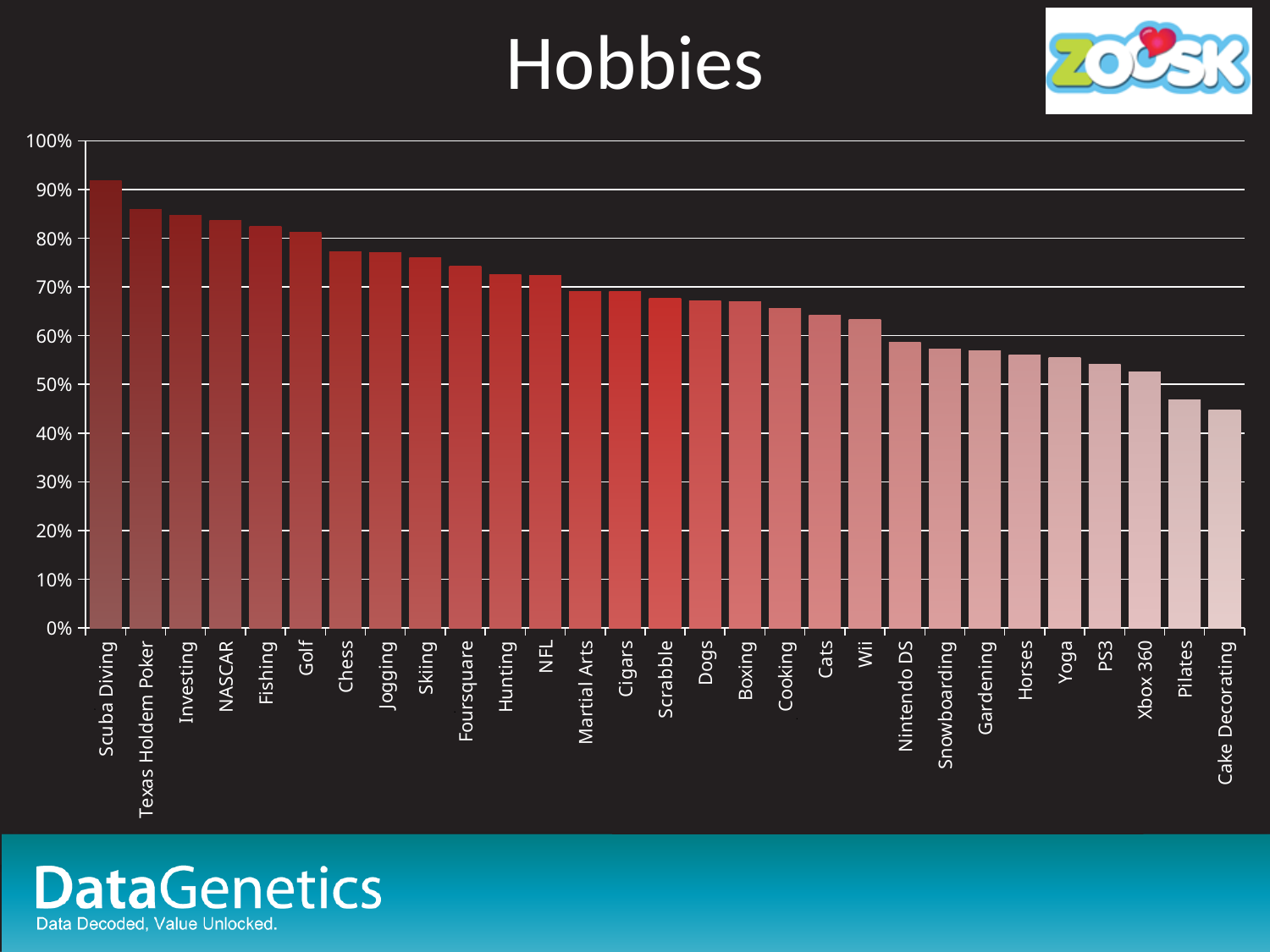
How many hobbies are plotted on the chart? 29 Is the value for Scuba Diving greater or less than 90%? greater Is the value for Chess greater or less than 80%? less What kind of chart is shown on the slide? bar chart Which is larger, the value for Fishing or the value for Yoga? Fishing Do the values rise or fall moving from left to right along the x axis? fall Is the value for Cooking greater or less than 60%? greater Which hobby has the highest value? Scuba Diving What is the title of the chart? Hobbies Which hobby has the lowest value? Cake Decorating